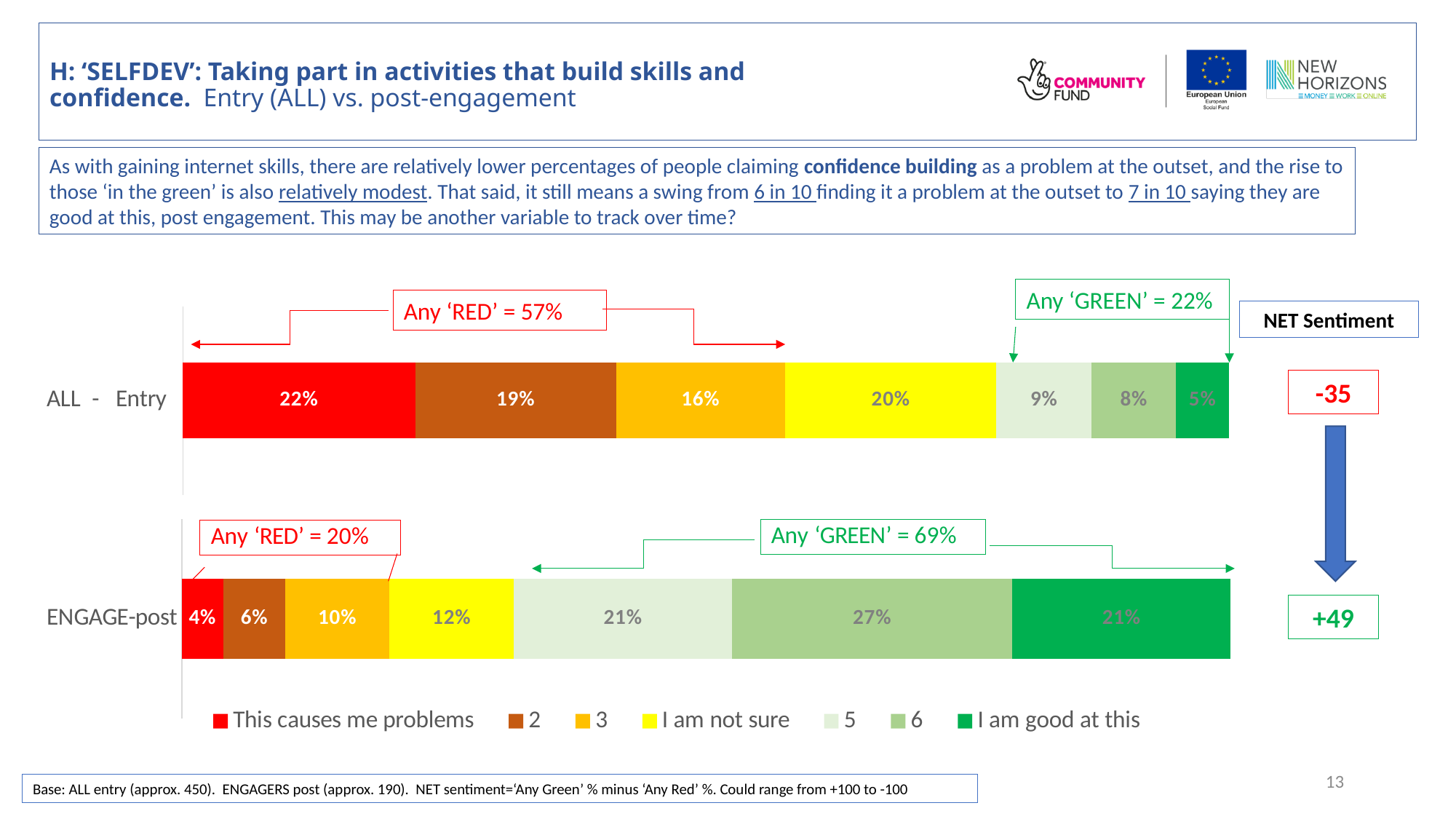
What is the value for rating 6 in the ENGAGE-post bar? 27% What kind of chart is shown on the slide? Stacked bar chart Which segment is the smallest in the ALL - Entry bar? I am good at this What is the difference between the 'This causes me problems' values for ALL - Entry and ENGAGE-post? 18% What is the value for rating 5 in the ALL - Entry bar? 9% Which segment is the largest in the ENGAGE-post bar? 6 What percentage of the ENGAGE-post bar is 'I am not sure'? 12% How many series does the legend list? 7 What percentage of the ALL - Entry bar is 'This causes me problems'? 22% Which is larger: the 'I am not sure' value for ALL - Entry or for ENGAGE-post? ALL - Entry How many categories (bars) are plotted in the chart? 2 What is the NET Sentiment shown for ENGAGE-post? +49